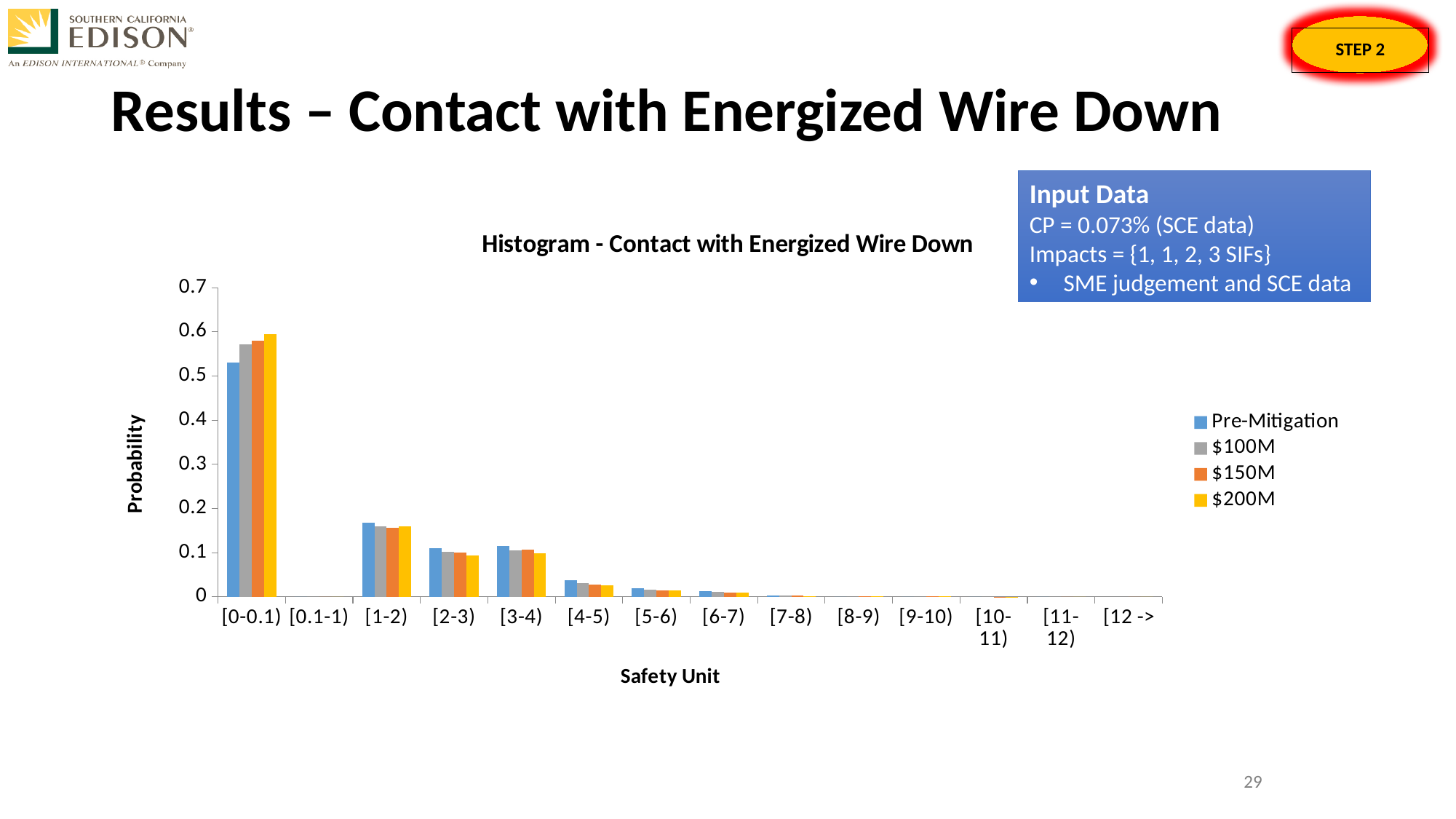
Is the Pre-Mitigation value for [1-2) greater or less than 0.1? greater How many series does the legend list? 4 Which Safety Unit category has the highest probability for the Pre-Mitigation series? [0-0.1) Is the Pre-Mitigation value for [4-5) greater or less than 0.1? less For the [0-0.1] category, which is larger: the Pre-Mitigation value or the $200M value? $200M Is the $200M value for [0-0.1] greater or less than 0.5? greater For the Pre-Mitigation series, which is larger: the value for [1-2) or the value for [2-3)? [1-2) How many categories are shown on the x axis? 14 What is the title of the chart? Histogram - Contact with Energized Wire Down What kind of chart is shown on the slide? Bar chart